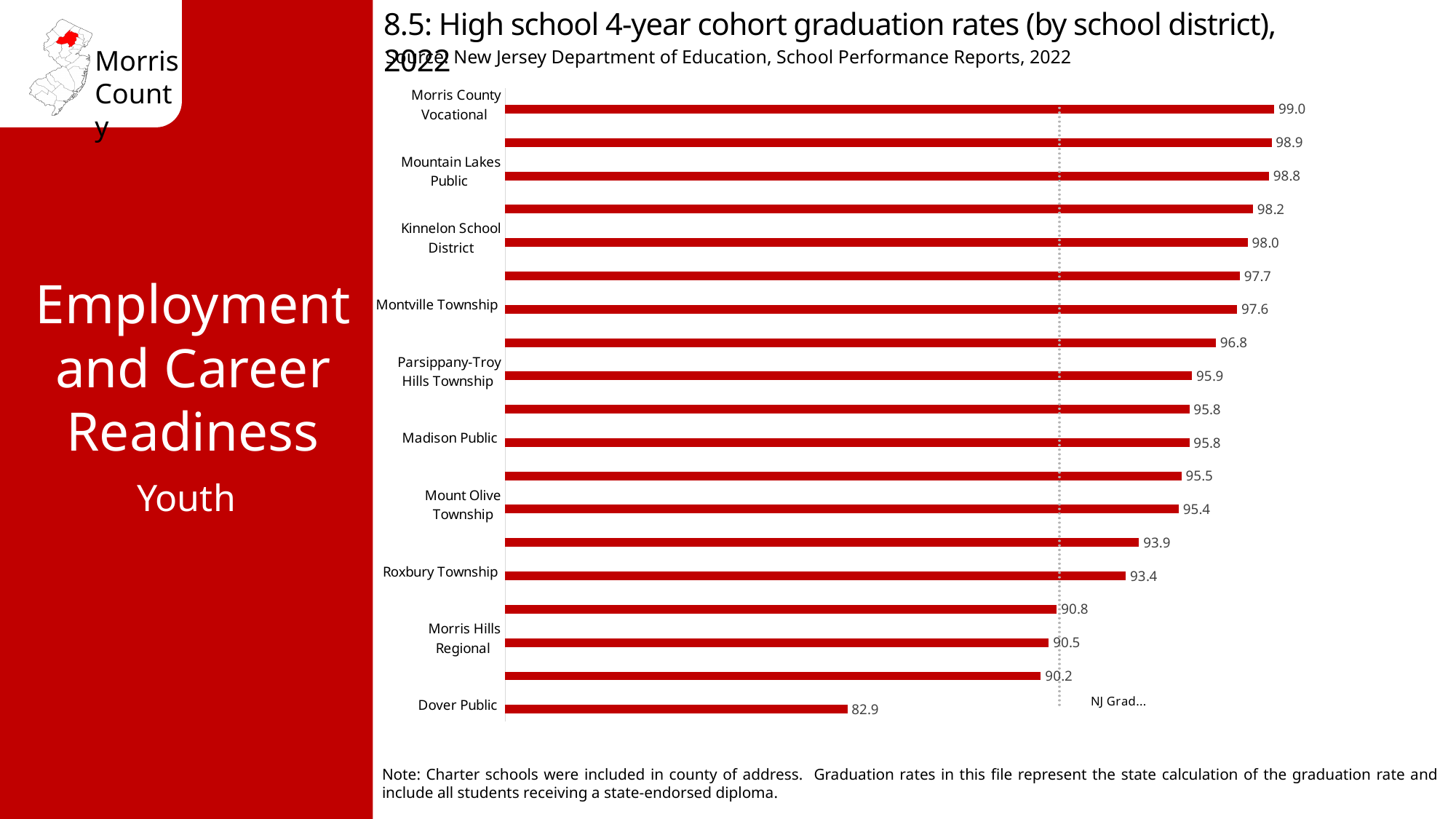
Which labeled school district has the highest graduation rate? Morris County Vocational What is the difference between the graduation rates of Morris County Vocational and Dover Public? 16.1 What is the graduation rate for Dover Public? 82.9 What is the graduation rate for Morris Hills Regional? 90.5 What type of chart is shown on the slide? Bar chart What is the graduation rate for Morris County Vocational? 99.0 Which labeled school district has the lowest graduation rate? Dover Public What is the graduation rate for Roxbury Township? 93.4 Which has a higher graduation rate, Madison Public or Mount Olive Township? Madison Public What is the difference between the graduation rates of Mountain Lakes Public and Montville Township? 1.2 What is the graduation rate for Kinnelon School District? 98.0 How many bars are plotted in the chart? 19